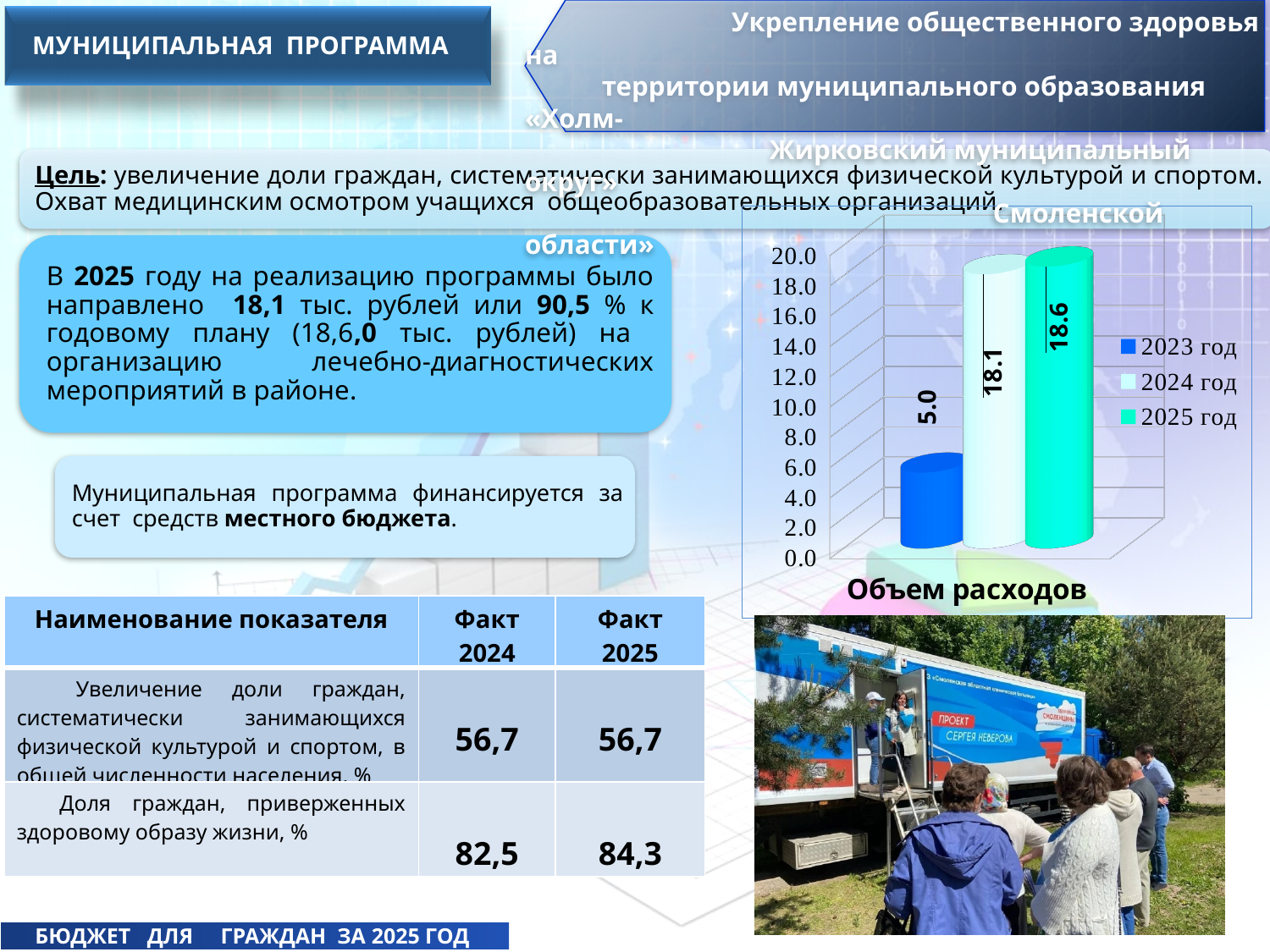
What kind of chart is shown on the slide? bar chart Which year has the highest value in the chart? 2025 год Is the value for 2023 год greater or less than 10.0? less What is the difference between the values for 2024 год and 2023 год? 13.1 What is the value for 2024 год in the chart? 18.1 What is the title of the chart? Объем расходов How many series does the legend list? 3 What is the difference between the values for 2025 год and 2024 год? 0.5 What is the value for 2023 год in the chart? 5.0 Which is larger, the value for 2023 год or the value for 2024 год? 2024 год What is the value for 2025 год in the chart? 18.6 Which year has the lowest value in the chart? 2023 год